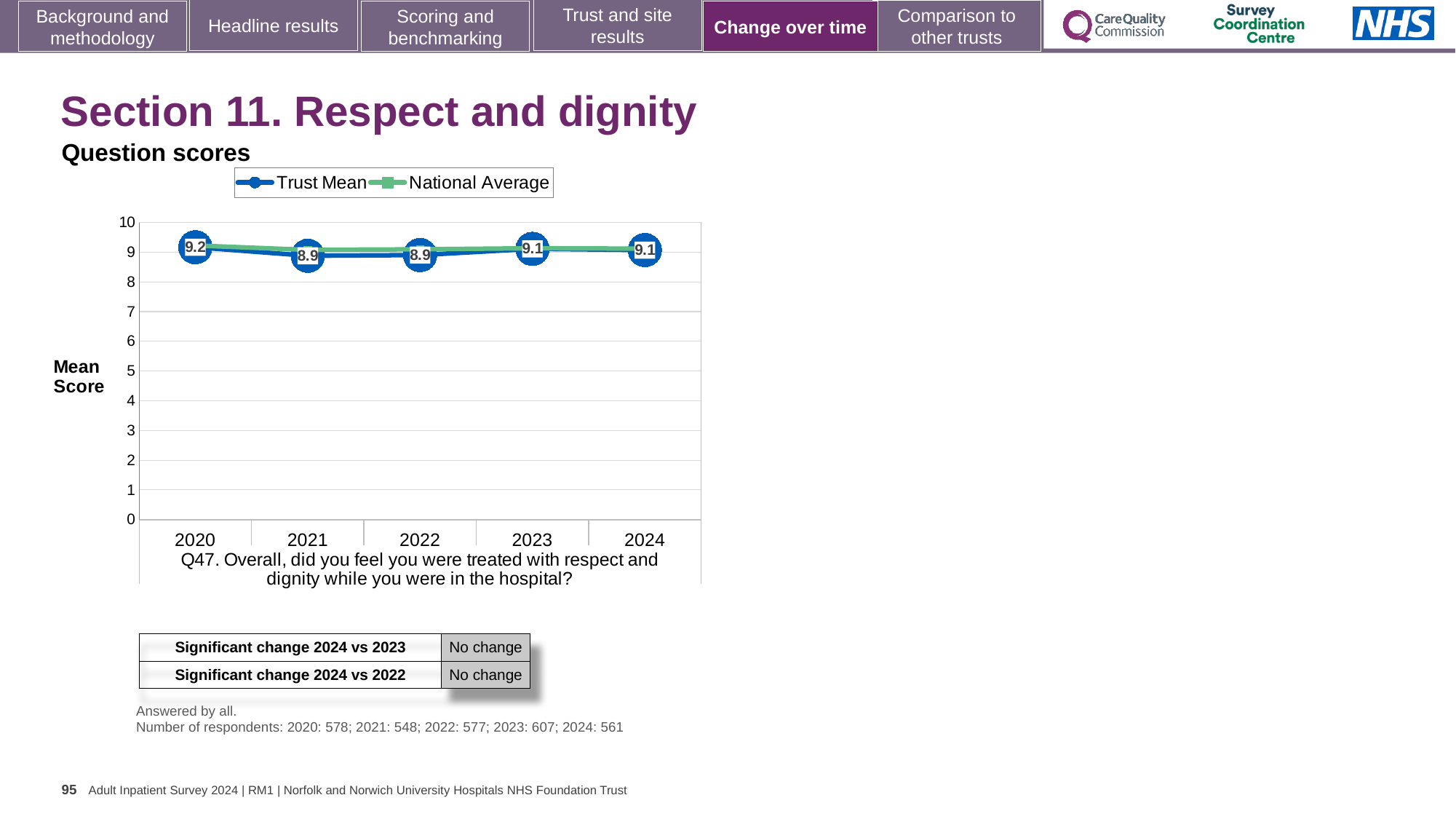
What is the Trust Mean score for 2021? 8.9 What is the Trust Mean score for 2024? 9.1 In which year is the Trust Mean score highest? 2020 Which is larger, the Trust Mean score for 2020 or for 2022? 2020 How many series does the legend list? 2 Is the National Average value for 2024 greater or less than 5? greater Between 2021 and 2023, does the Trust Mean score rise or fall? rise How many years are plotted on the x axis? 5 What is the Trust Mean score for 2023? 9.1 What kind of chart is shown on the slide? line chart What is the difference between the Trust Mean scores for 2020 and 2021? 0.3 What is the Trust Mean score for 2020? 9.2